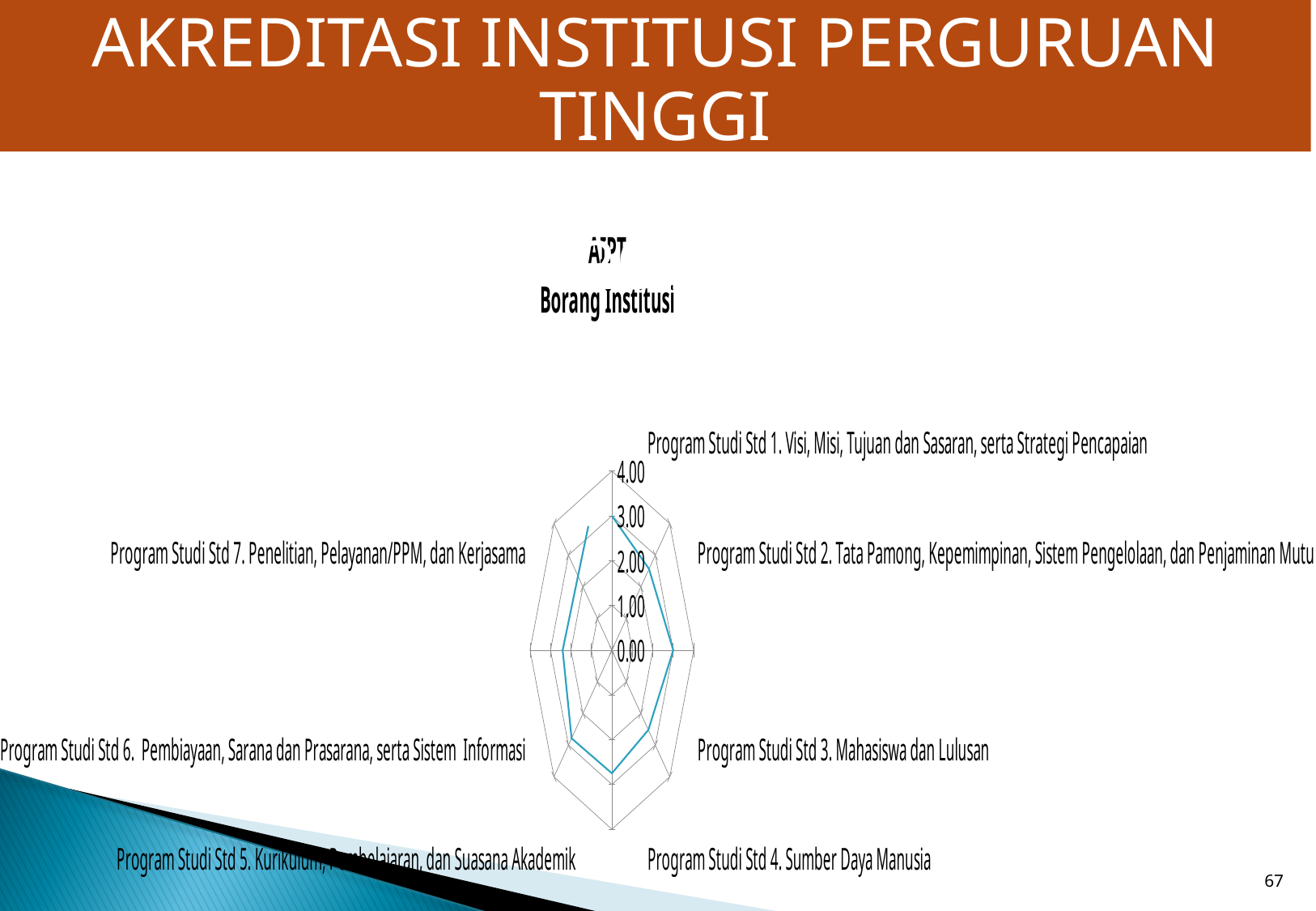
Is the value for Program Studi Std 4. Sumber Daya Manusia greater or less than 4.00? less How many data series are plotted on the radar chart? 1 What kind of chart is shown on the slide? Radar chart Is the value for Program Studi Std 5. Kurikulum, Pembelajaran, dan Suasana Akademik greater or less than 1.00? greater Is the value for Program Studi Std 2. Tata Pamong, Kepemimpinan, Sistem Pengelolaan, dan Penjaminan Mutu greater or less than 4.00? less How many categories (axes) does the radar chart have? 7 What is the highest value shown on the radar chart's axis scale? 4.00 What is the title of the radar chart? AIPT Borang Institusi